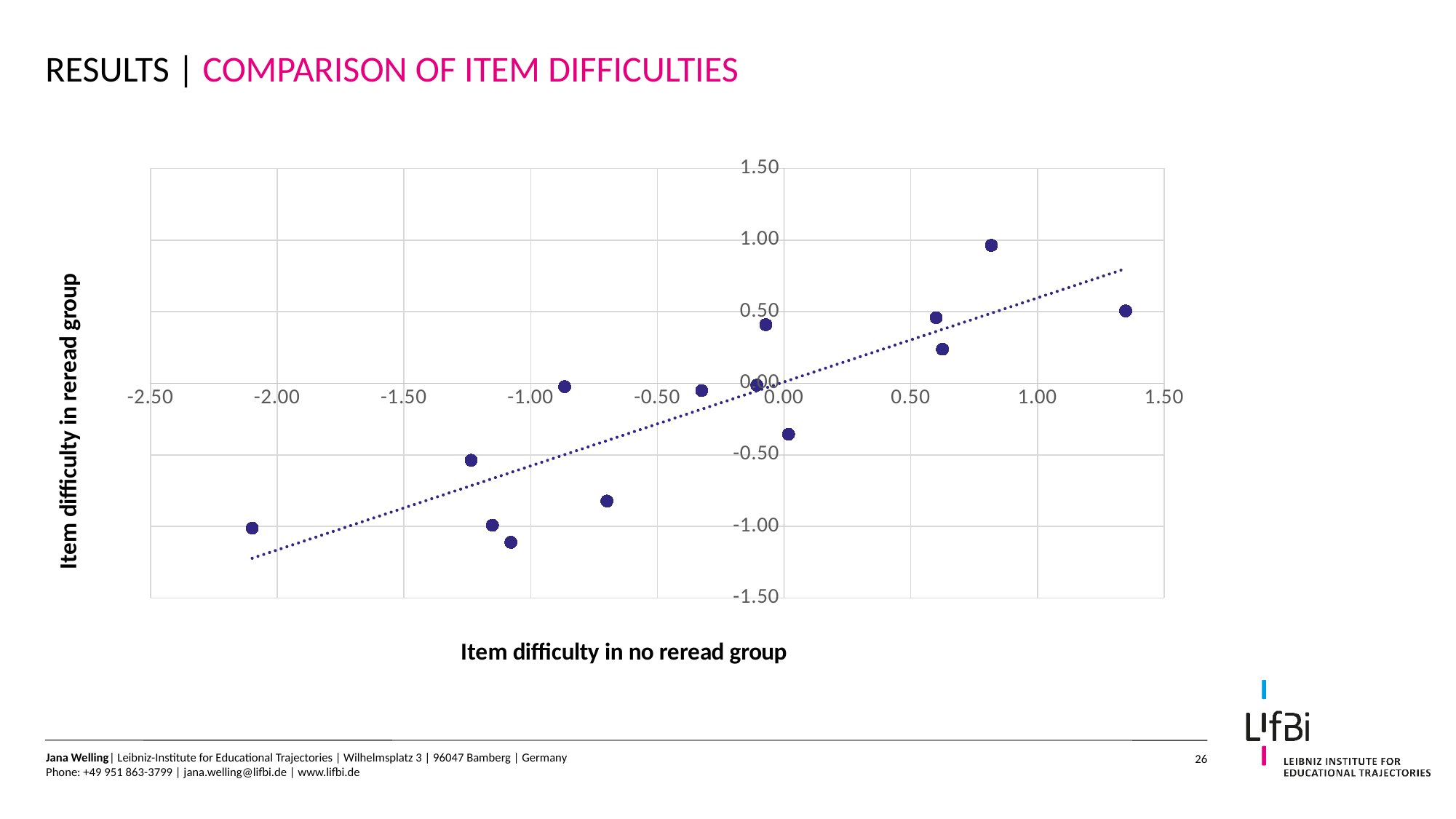
Is the y value of the point with the lowest x value (around -2.10) greater or less than -0.50? less How many data points are plotted in the chart? 14 Is the y value of the point with the highest x value larger or smaller than the y value of the point with the lowest x value? larger Is the y value of the highest point in the chart greater or less than 0.50? greater What is the title of the x axis of the chart? Item difficulty in no reread group How many points have an x value greater than 0.50? 4 Is the y value of the point with the highest x value (around 1.35) greater or less than 1.00? less Do the plotted points generally rise or fall as the x value increases? Rise What kind of chart is shown on the slide? Scatter plot What is the maximum value shown on the y axis? 1.50 What is the title of the y axis of the chart? Item difficulty in reread group How many points have a y value greater than 1.00? 0